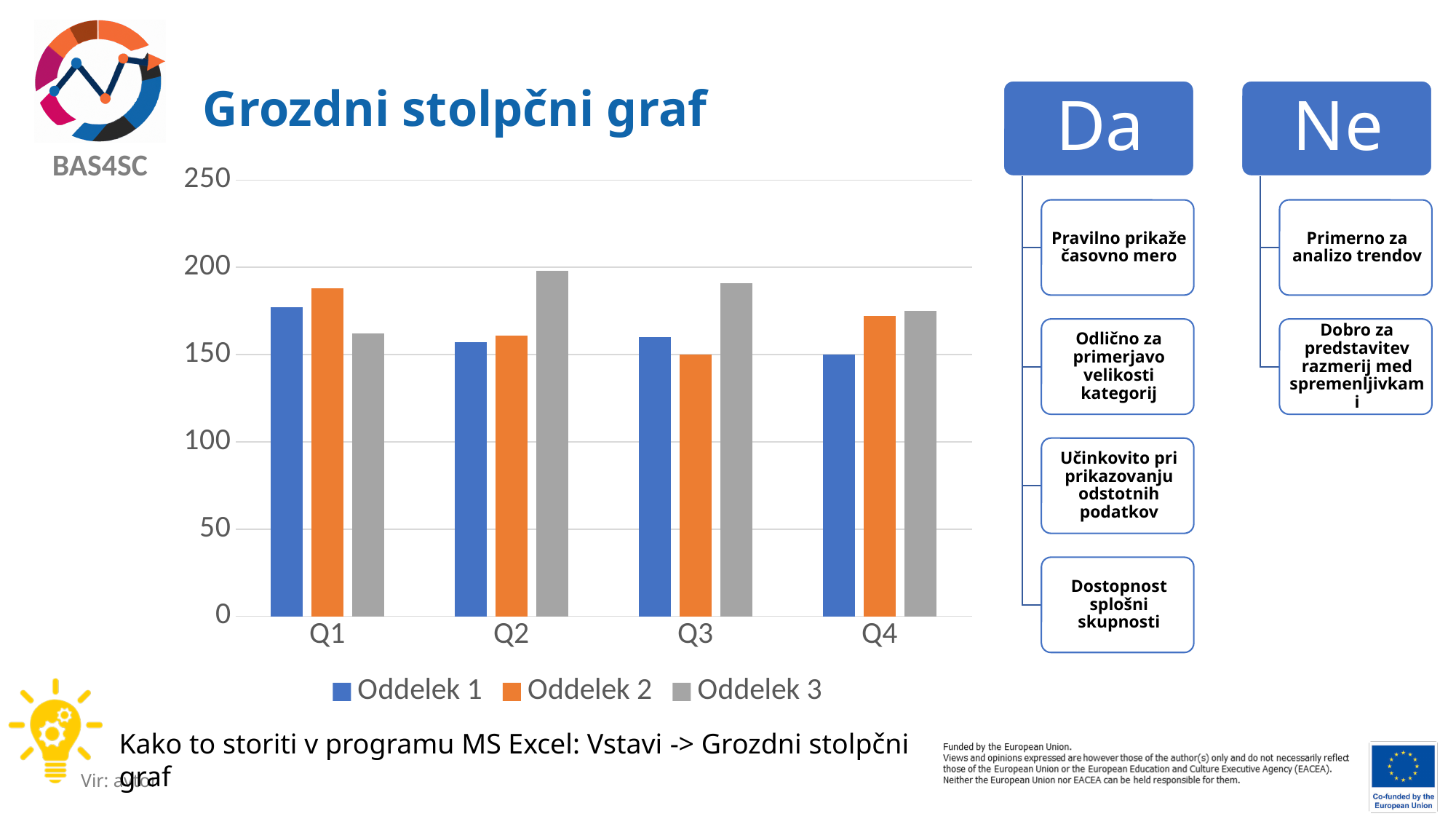
Which colour represents Oddelek 2 in the chart? orange What is the title of the chart? Grozdni stolpčni graf Is the value for Oddelek 3 in Q1 greater or less than 200? less In Q1, which is larger: the value for Oddelek 1 or the value for Oddelek 3? Oddelek 1 Is the value for Oddelek 1 in Q4 greater or less than 200? less Is the value for Oddelek 2 in Q1 greater or less than 150? greater How many categories are shown on the x axis of the chart? 4 Which series has the lowest value in Q4? Oddelek 1 Which series has the highest value in Q2? Oddelek 3 How many series does the chart legend list? 3 What kind of chart is shown on the slide? bar chart